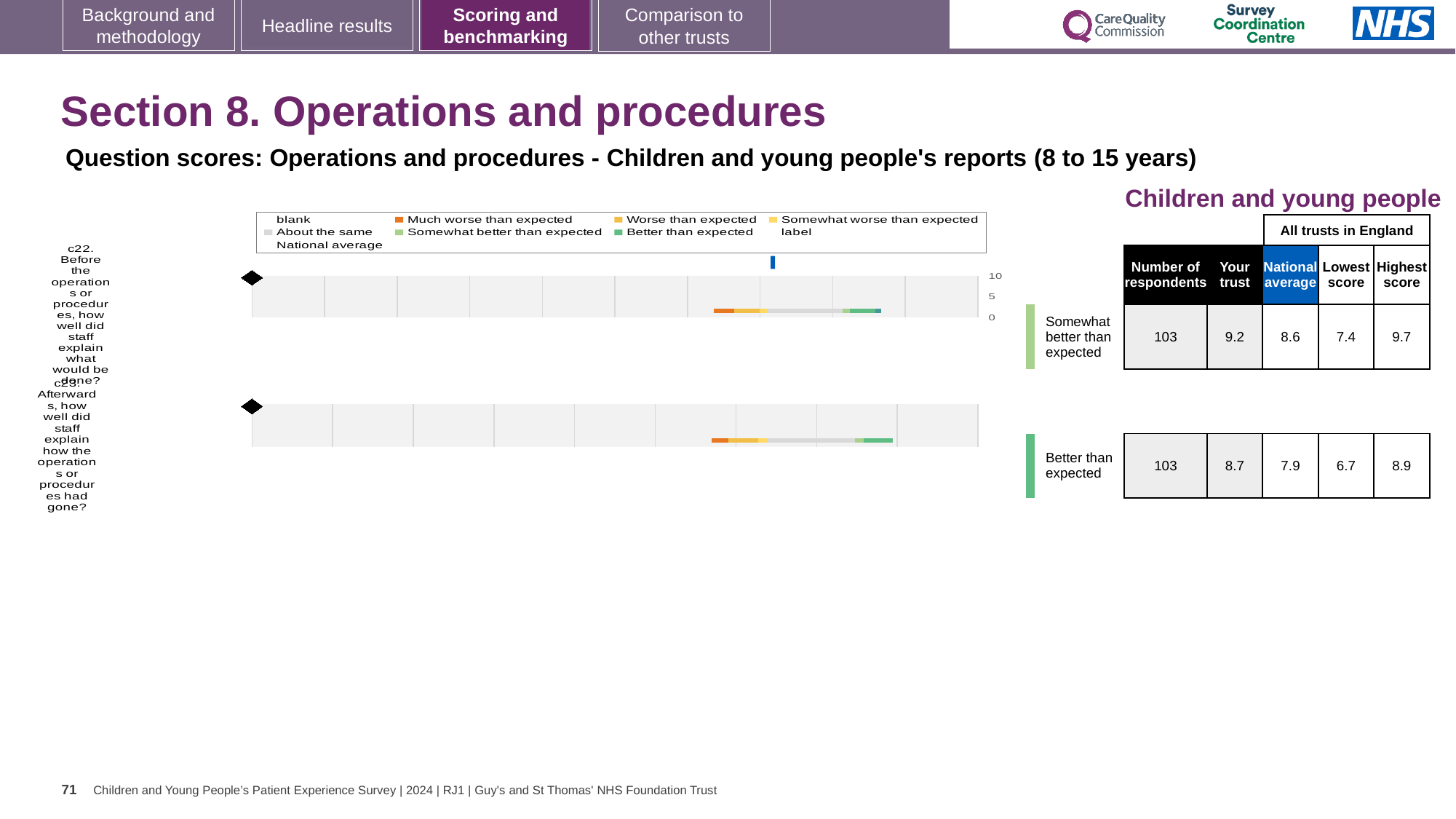
How many respondents answered question c23? 103 According to the table beside the chart, what is the Lowest score among all trusts in England for c22? 7.4 According to the table beside the chart, what is the Highest score among all trusts in England for c23? 8.9 According to the table beside the chart, what is the National average score for c22? 8.6 How many questions (bars) are plotted in the chart? 2 What colour does the legend use for 'Much worse than expected'? Orange What kind of chart is used to show the question scores for c22 and c23? bar chart Which benchmark category is the trust's score for c23 placed in? Better than expected Which question has the higher 'Your trust' score, c22 or c23? c22 What is the difference between the 'Your trust' score and the National average for c22? 0.6 According to the table beside the chart, what is the 'Your trust' score for c22 (Before the operations or procedures, how well did staff explain what would be done?)? 9.2 According to the table beside the chart, what is the 'Your trust' score for c23 (Afterwards, how well did staff explain how the operations or procedures had gone?)? 8.7